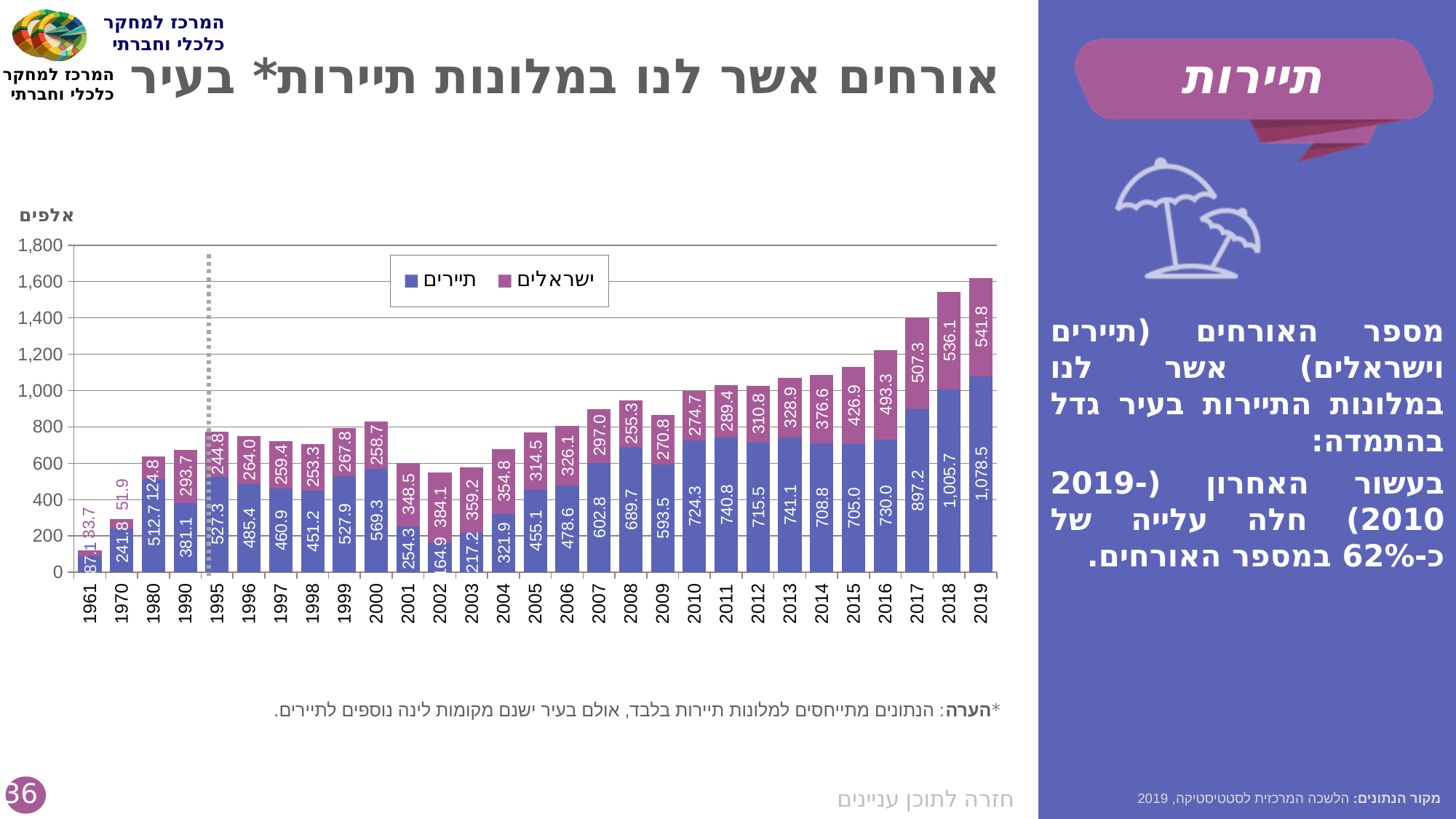
What is the value for תיירים (tourists) in 2008? 689.7 What is the value for ישראלים (Israelis) in 2002? 384.1 What kind of chart is shown on the slide? stacked bar chart In 2002, which is larger: the value for תיירים or the value for ישראלים? ישראלים Which year has the lowest value for ישראלים (Israelis)? 1961 Which year has the highest value for תיירים (tourists)? 2019 What is the difference between the תיירים and ישראלים values in 2019? 536.7 Is the total height of the 2019 bar greater or less than 1,600? greater What is the total of the stacked bar for 2018? 1,541.8 How many series does the legend list? 2 What is the value for תיירים (tourists) in 2019? 1,078.5 How many years are shown on the x axis? 29